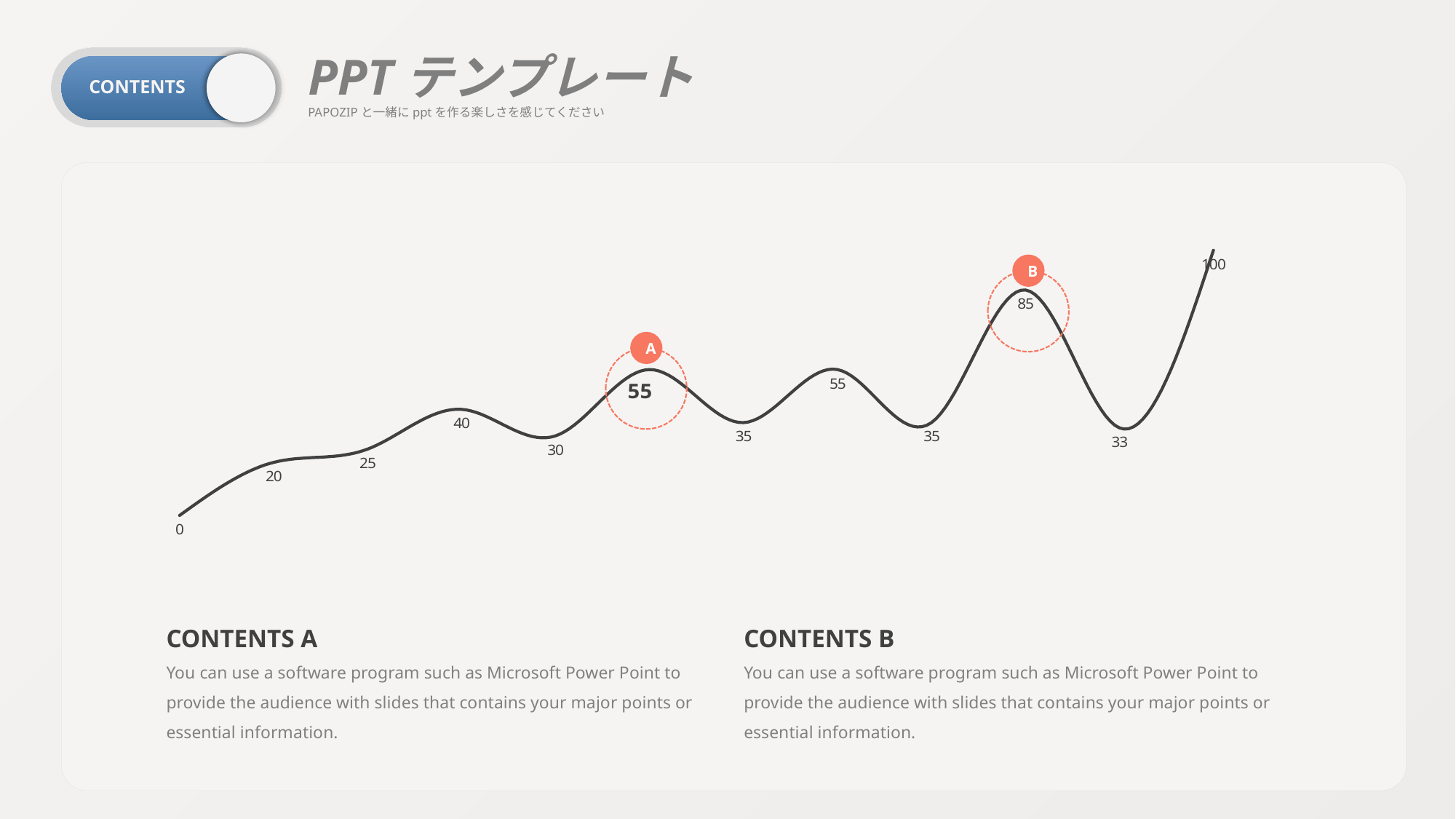
What is the highest value labelled on the line chart? 100 Does the line overall rise or fall from the first point to the last point? rise What kind of chart is shown on the slide? line chart Which marked point has the larger value, A or B? B How many data points are labelled on the line chart? 12 What is the lowest value labelled on the line chart? 0 What is the difference between the values at marker B and marker A? 30 What is the value of the last point on the line chart? 100 What is the value of the first point on the line chart? 0 What is the difference between the last point (100) and the point just before it (33)? 67 What is the value of the point marked B on the line chart? 85 What is the value of the point marked A on the line chart? 55